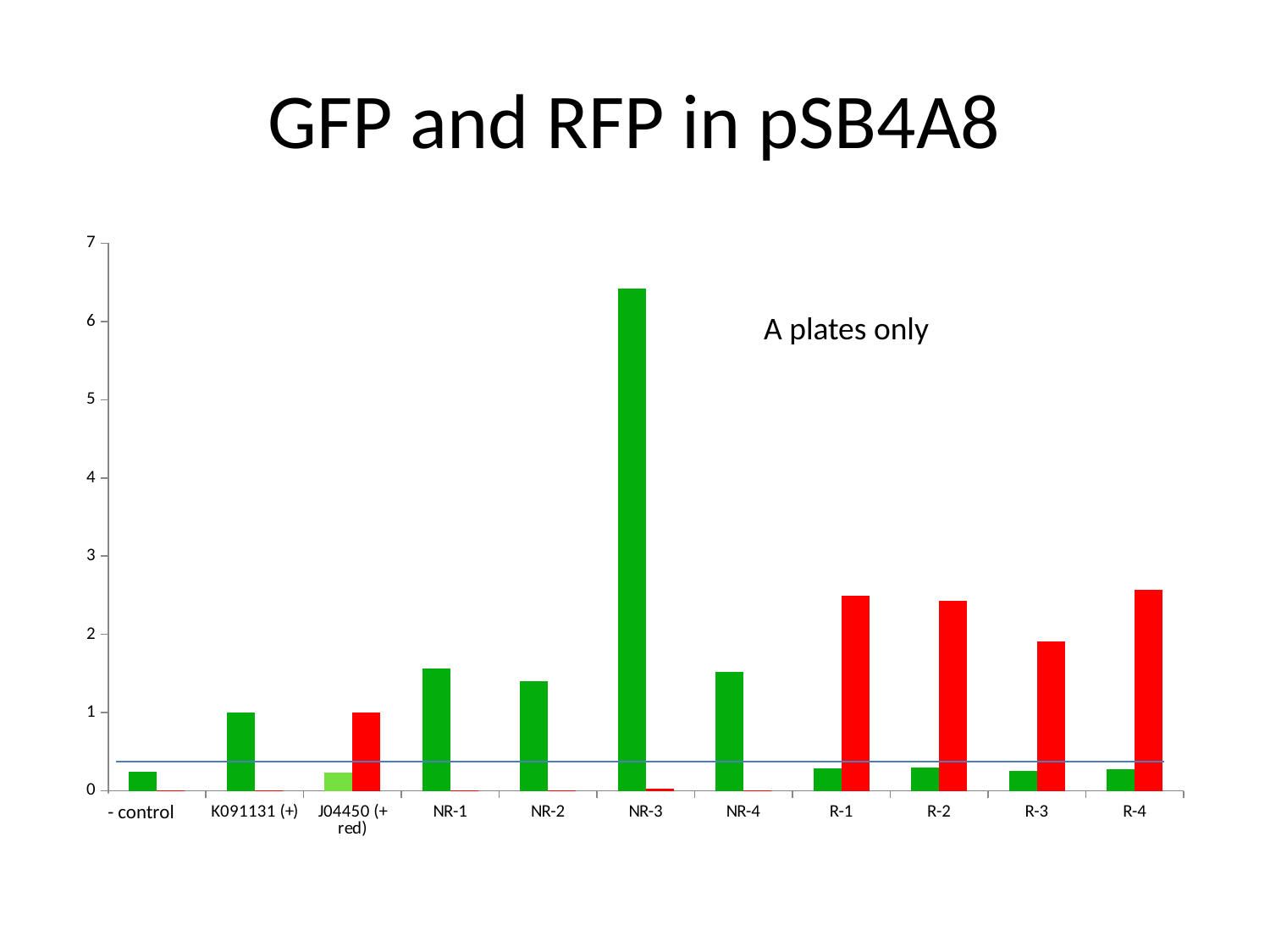
Is the red bar for R-3 greater or less than 2? less Which is larger: the green bar for NR-3 or the red bar for R-1? the green bar for NR-3 Is the red bar for R-1 greater or less than 2? greater What text annotation appears inside the plot area of the chart? A plates only Is the green bar for NR-3 greater or less than 6? greater What kind of chart is shown on the slide? bar chart Which category has the tallest green bar in the chart? NR-3 What is the title of the chart? GFP and RFP in pSB4A8 Which category has the tallest red bar in the chart? R-4 How many categories are shown along the x axis of the chart? 11